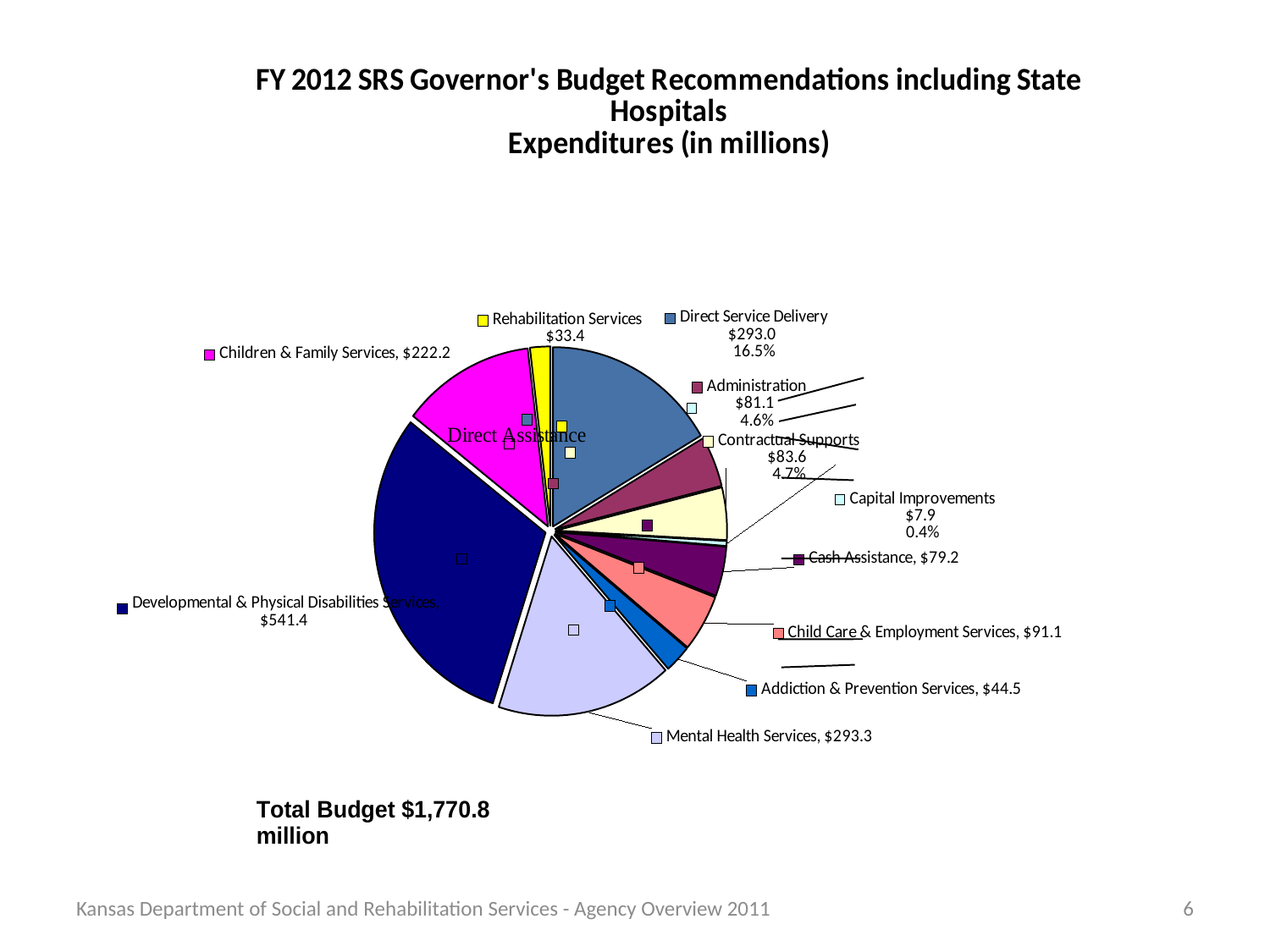
How many categories (slices) are shown in the pie chart? 11 Which category has the largest slice of the pie? Developmental & Physical Disabilities Services What is the expenditure value shown for Rehabilitation Services? $33.4 What total budget is stated below the chart? $1,770.8 million Which is larger, Child Care & Employment Services or Addiction & Prevention Services? Child Care & Employment Services What is the difference between the values for Children & Family Services and Rehabilitation Services? $188.8 What percentage share of the pie is shown for Capital Improvements? 0.4% Which category has the smallest slice of the pie? Capital Improvements What is the expenditure value shown for Mental Health Services? $293.3 What percentage share of the pie is shown for Direct Service Delivery? 16.5% What is the expenditure value shown for Developmental & Physical Disabilities Services? $541.4 What kind of chart is shown on the slide? Pie chart